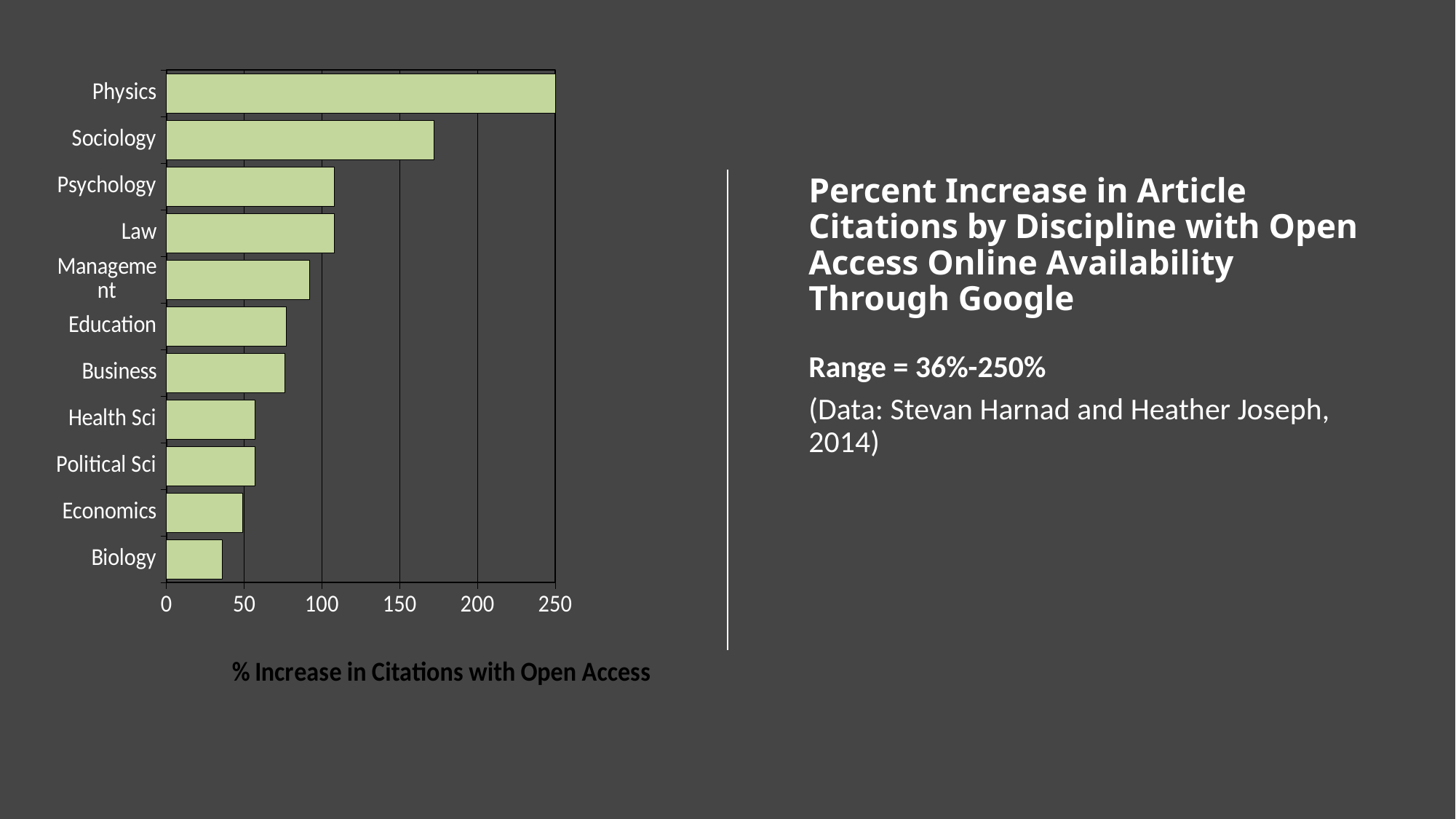
What is the title of the horizontal axis of the chart? % Increase in Citations with Open Access What kind of chart is shown on the slide? bar chart Is the value for Management greater or less than 100? less What is the percent increase in citations for Physics? 250 Is the value for Education greater or less than 50? greater Which discipline has the lowest percent increase in citations? Biology How many disciplines are plotted in the chart? 11 Is the value for Biology greater or less than 50? less Which discipline has the highest percent increase in citations? Physics Which has a larger percent increase in citations, Business or Economics? Business Which has a larger percent increase in citations, Sociology or Psychology? Sociology